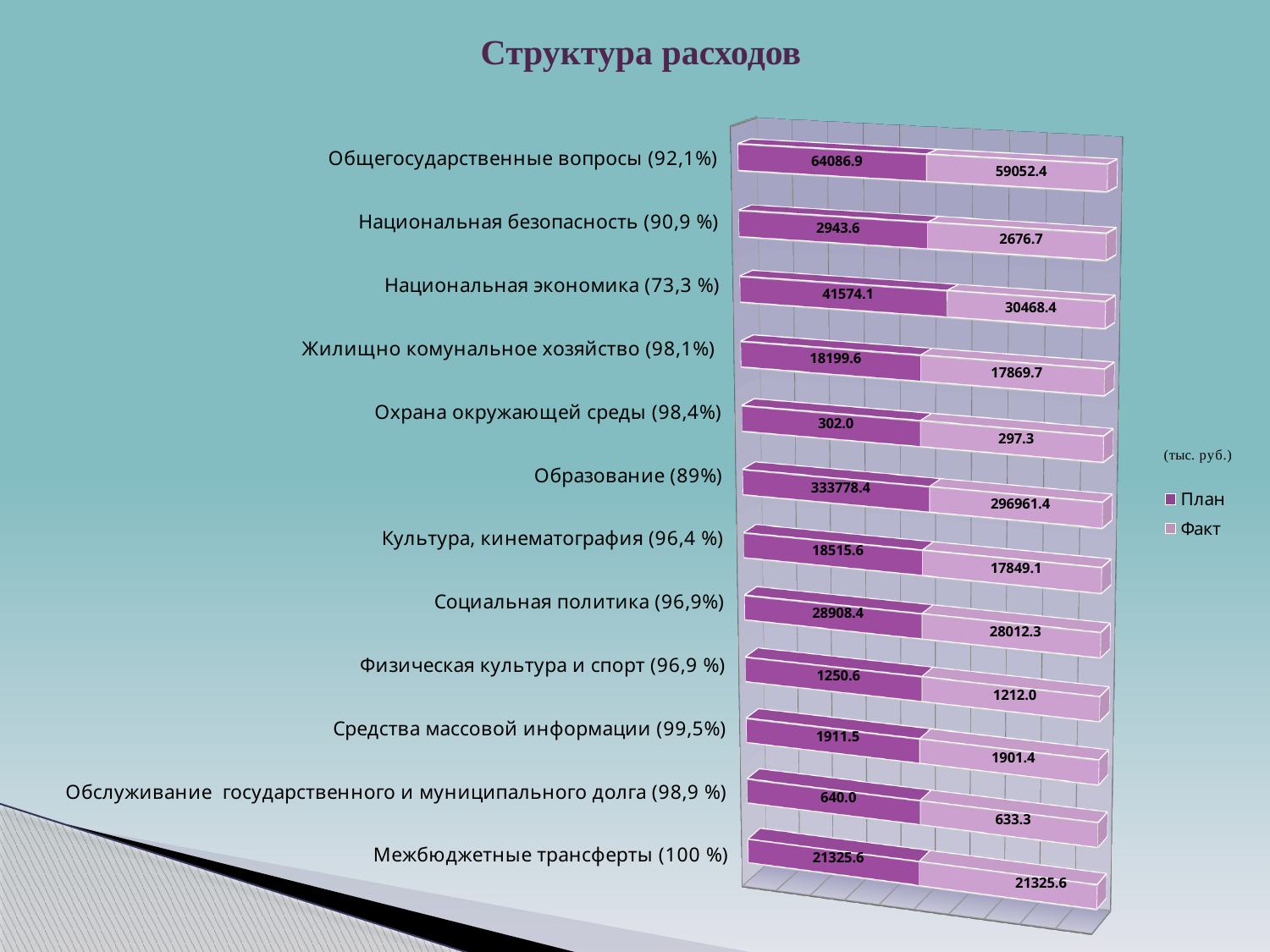
What is the Факт value for Национальная экономика (73,3 %)? 30468.4 How many categories are shown in the chart? 12 What kind of chart is shown on the slide? Bar chart What is the difference between the План and Факт values for Национальная экономика (73,3 %)? 11105.7 Which has the larger План value: Социальная политика (96,9%) or Культура, кинематография (96,4 %)? Социальная политика (96,9%) What is the План value for Образование (89%)? 333778.4 Which category has the highest План value? Образование (89%) What is the difference between the План and Факт values for Общегосударственные вопросы (92,1%)? 5034.5 How many series does the legend list? 2 What is the total of the stacked bar for Физическая культура и спорт (96,9 %)? 2462.6 What is the Факт value for Средства массовой информации (99,5%)? 1901.4 Which category has the lowest Факт value? Охрана окружающей среды (98,4%)